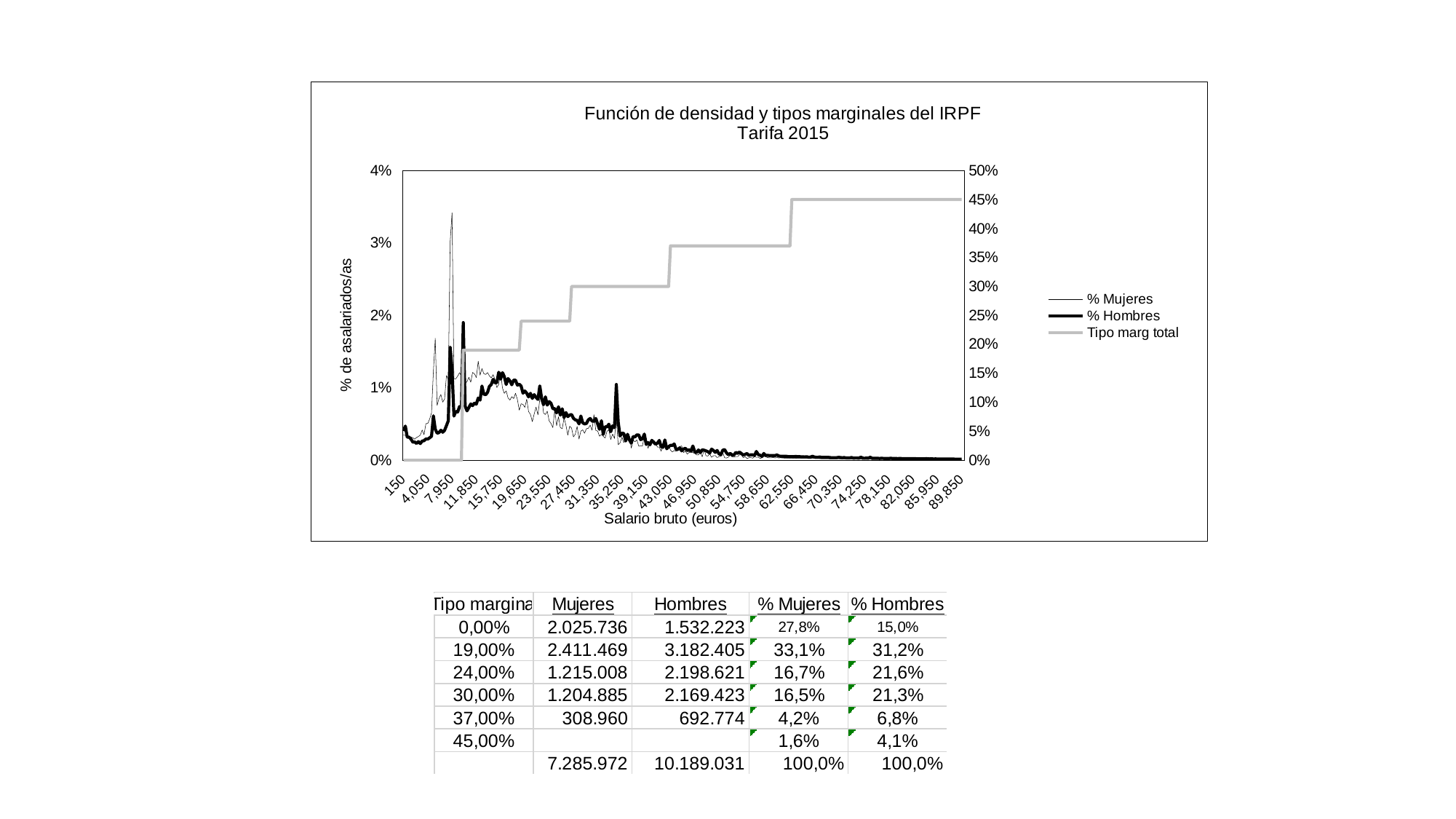
What kind of chart is shown on the slide? line chart Is the highest peak of the % Hombres line greater or less than 2%? less What is the value of Tipo marg total at a gross salary of 31,350 euros? 30% Is the highest peak of the % Mujeres line greater or less than 3%? greater Does the Tipo marg total line rise or fall as gross salary increases along the x axis? rise Is the value of Tipo marg total at 50,850 euros greater or less than 30%? greater How many series does the chart legend list? 3 What is the title of the chart? Función de densidad y tipos marginales del IRPF Tarifa 2015 What is the label of the x axis of the chart? Salario bruto (euros) What is the value of Tipo marg total at a gross salary of 4,050 euros? 0% Which series reaches the highest peak on the left axis, % Mujeres or % Hombres? % Mujeres What is the value of Tipo marg total at a gross salary of 89,850 euros? 45%